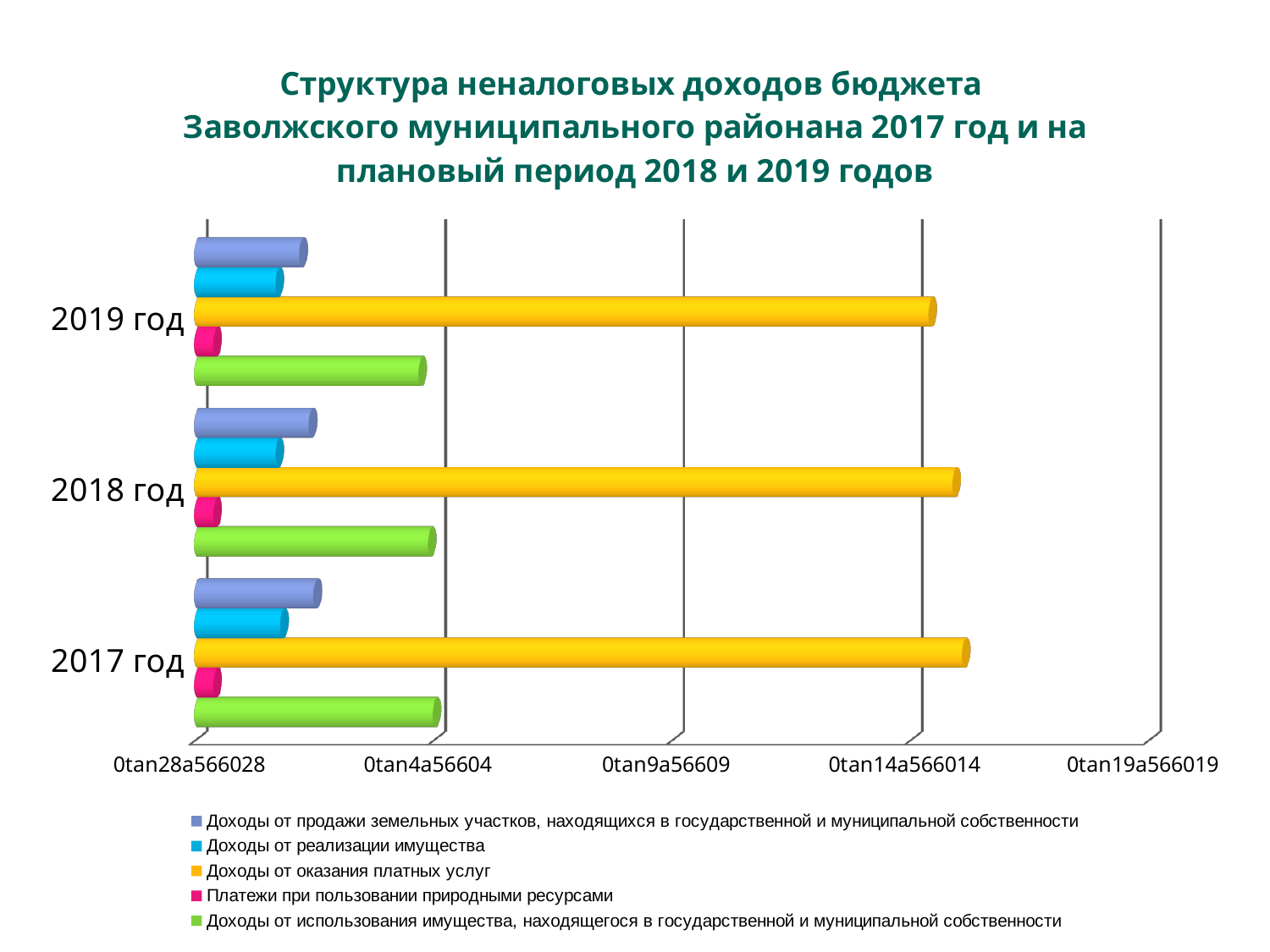
How many series does the legend list? 5 Which series has the shortest bar for 2017 год? Платежи при пользовании природными ресурсами Which series has the second-longest bar for 2018 год? Доходы от использования имущества, находящегося в государственной и муниципальной собственности What colour represents Платежи при пользовании природными ресурсами in the legend? Pink Does the bar for Доходы от оказания платных услуг rise or fall from 2017 год to 2019 год? Fall Which series has the longest bar for 2019 год? Доходы от оказания платных услуг What is the title of the chart? Структура неналоговых доходов бюджета Заволжского муниципального районана 2017 год и на плановый период 2018 и 2019 годов How many years (categories) are shown on the vertical axis of the chart? 3 What kind of chart is shown on the slide? Bar chart For 2019 год, which is larger: Доходы от использования имущества, находящегося в государственной и муниципальной собственности or Доходы от реализации имущества? Доходы от использования имущества, находящегося в государственной и муниципальной собственности Which series is the longest bar in every year shown? Доходы от оказания платных услуг For 2018 год, which is larger: Доходы от продажи земельных участков, находящихся в государственной и муниципальной собственности or Доходы от реализации имущества? Доходы от продажи земельных участков, находящихся в государственной и муниципальной собственности